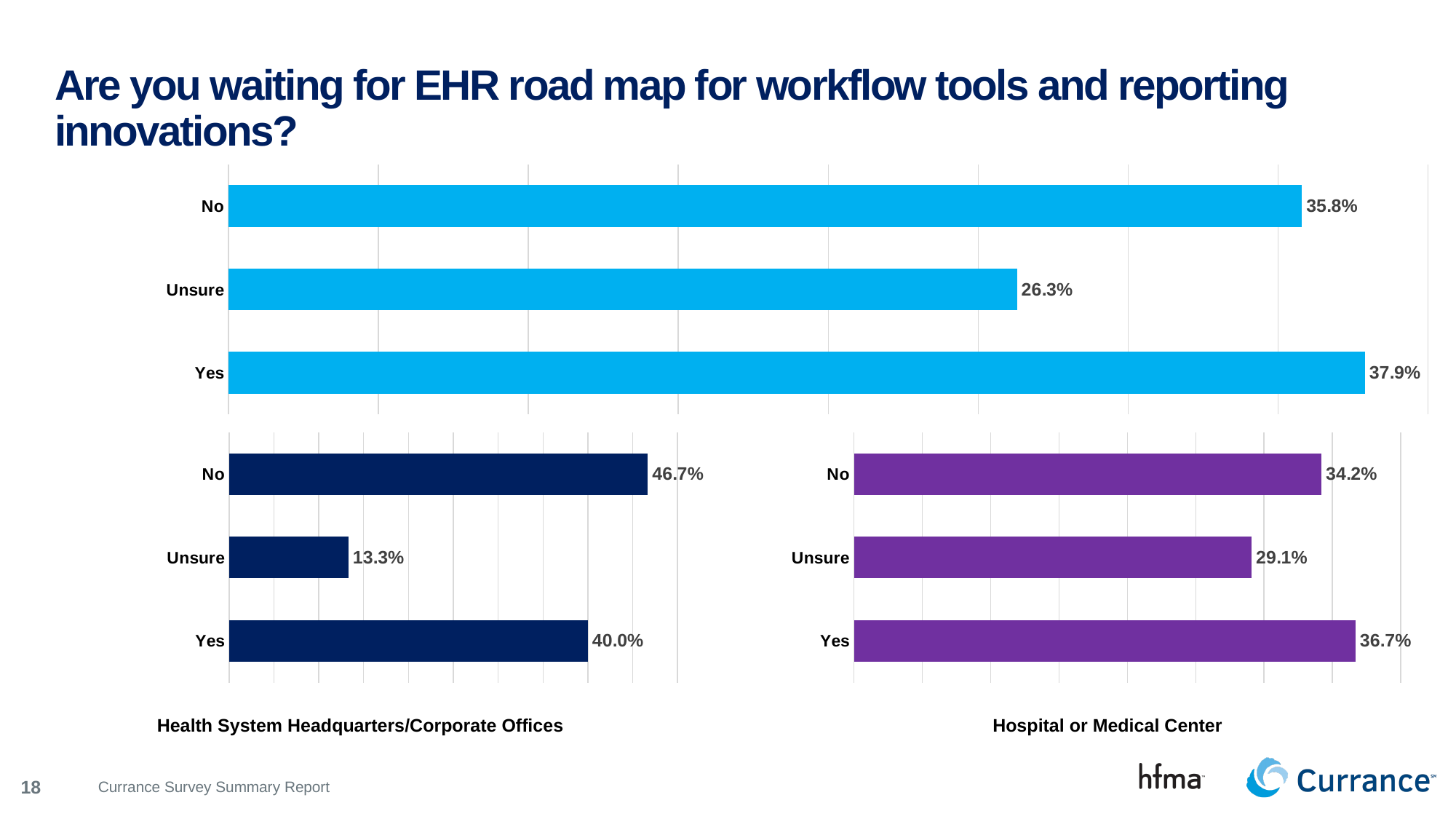
Which is larger: Unsure in the Health System Headquarters/Corporate Offices chart or Unsure in the Hospital or Medical Center chart? Hospital or Medical Center In the top chart, which category has the lowest value? Unsure In the top chart, what is the value for Unsure? 26.3% In the Hospital or Medical Center chart, what is the value for Unsure? 29.1% In the Hospital or Medical Center chart, what is the difference between Yes and Unsure? 7.6% In the Health System Headquarters/Corporate Offices chart, which category has the highest value? No What kind of chart is the Hospital or Medical Center chart? Bar chart In the Health System Headquarters/Corporate Offices chart, what is the value for No? 46.7% How many categories does the top chart show? 3 In the Health System Headquarters/Corporate Offices chart, what is the difference between No and Yes? 6.7% In the Hospital or Medical Center chart, which category has the highest value? Yes In the top chart, what is the value for No? 35.8%